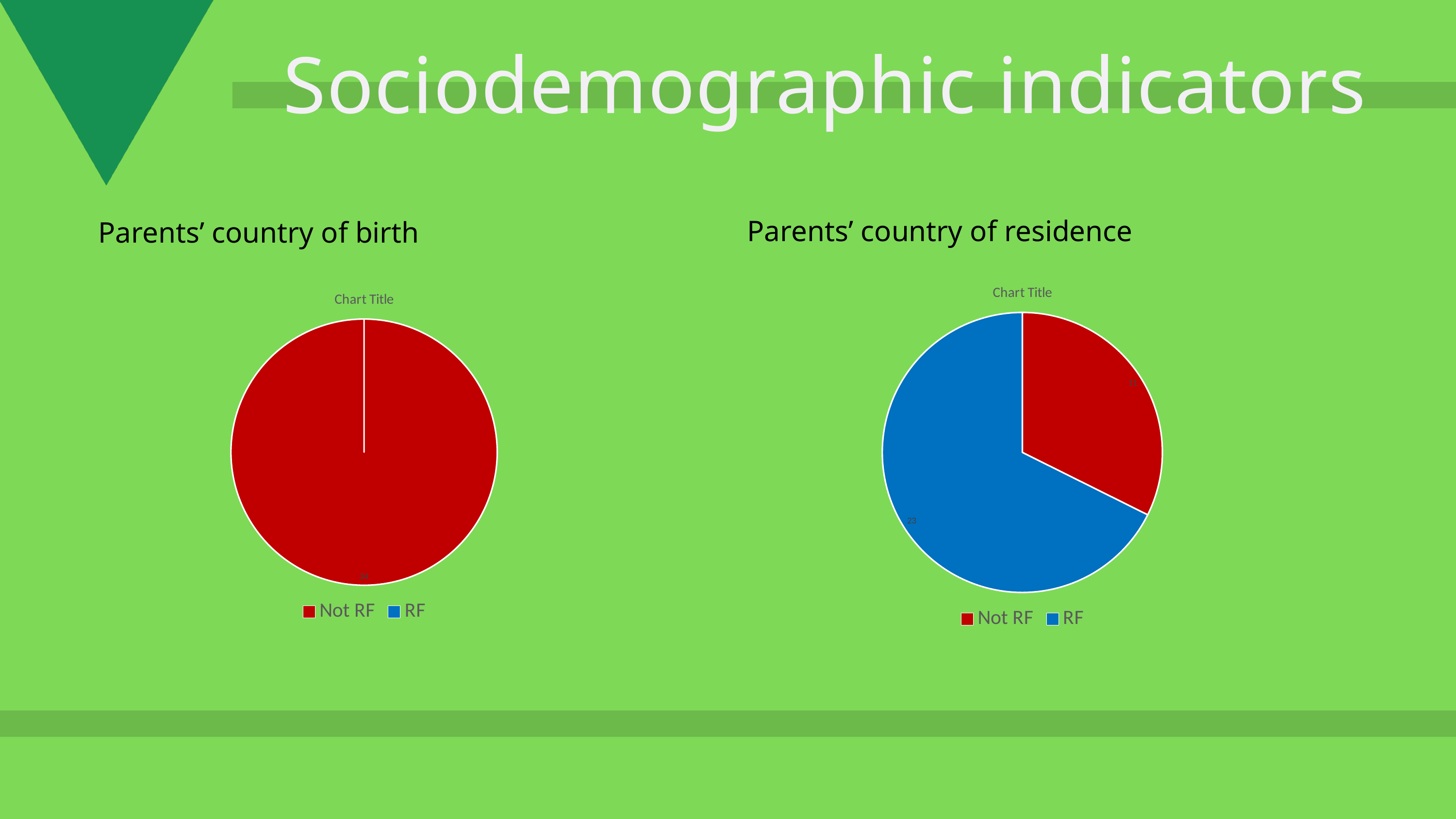
In the Parents' country of residence chart, is the RF slice larger or smaller than the Not RF slice? larger How many categories does the legend of the Parents' country of birth chart list? 2 In the Parents' country of birth chart, which category makes up the entire pie? Not RF What colour represents RF in the Parents' country of residence chart? blue What colour represents Not RF in the Parents' country of birth chart? red In the Parents' country of residence chart, which category has the larger slice? RF What kind of chart is used for Parents' country of birth? pie chart In the Parents' country of residence chart, which category has the smaller slice? Not RF In the Parents' country of residence chart, what value is labelled on the RF slice? 23 How many categories does the legend of the Parents' country of residence chart list? 2 What kind of chart is used for Parents' country of residence? pie chart